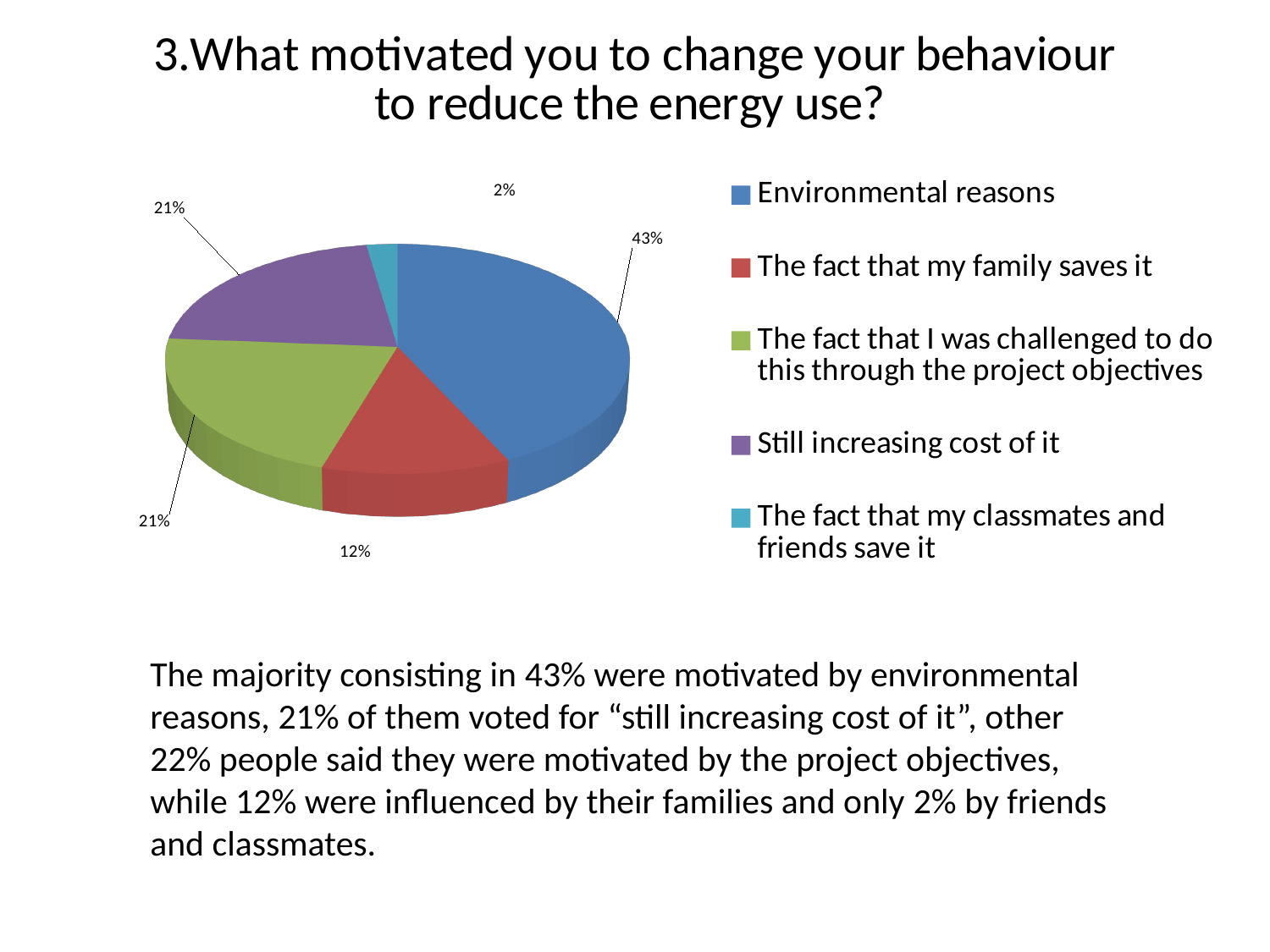
Which category has the smallest slice of the pie? The fact that my classmates and friends save it What percentage is shown for 'The fact that my classmates and friends save it'? 2% What percentage is shown for 'The fact that my family saves it'? 12% Which category has the largest slice of the pie? Environmental reasons What percentage of the pie is labelled for Environmental reasons? 43% What is the difference in percentage points between Environmental reasons and 'The fact that my family saves it'? 31 What is the title of the chart on the slide? 3.What motivated you to change your behaviour to reduce the energy use? What colour is the slice for Environmental reasons? blue Which is larger: the slice for Environmental reasons or the slice for 'Still increasing cost of it'? Environmental reasons What kind of chart is shown on the slide? pie chart How many categories does the legend list? 5 What percentage is shown for 'Still increasing cost of it'? 21%